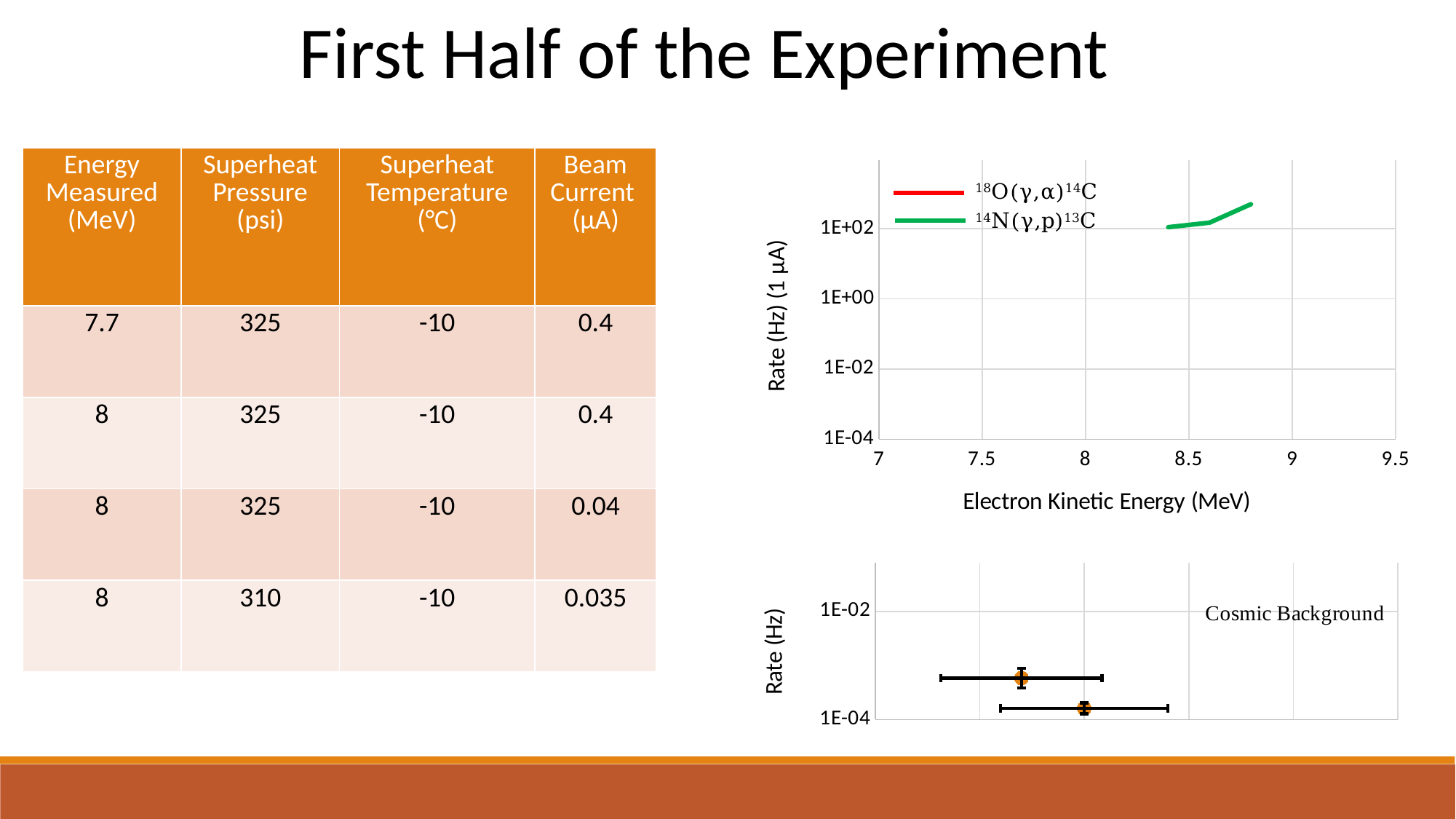
In the top chart, is the 14N(γ,p)13C rate at 8.8 MeV greater or less than 1E+02? greater In the top chart, what colour is the line for 14N(γ,p)13C? green What kind of chart is the top chart on the right of the slide? line chart In the top chart, how many series does the legend list? 2 In the top chart, what is the title of the x axis? Electron Kinetic Energy (MeV) In the bottom chart, what is the title of the y axis? Rate (Hz) In the bottom chart, which of the two data points has the higher rate, the left one or the right one? the left one In the bottom chart, is the rate of the higher data point greater or less than 1E-02? less In the top chart, does the 14N(γ,p)13C rate rise or fall as electron kinetic energy increases? rise In the top chart, is the 14N(γ,p)13C rate at 8.8 MeV greater or less than 1E+00? greater